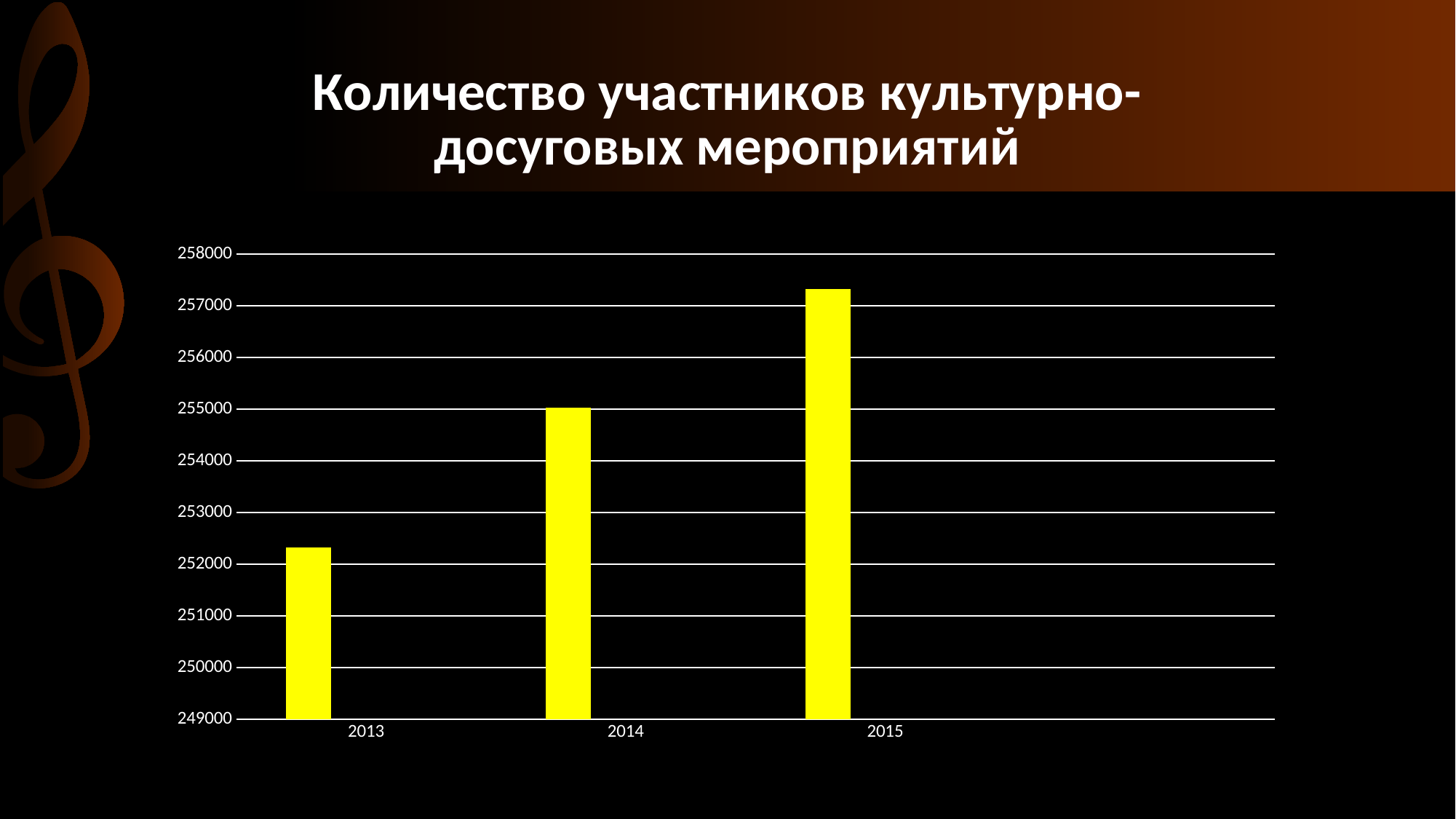
Which year has the highest number of participants? 2015 Which is larger, the value for 2013 or the value for 2015? 2015 What colour are the bars in the chart? yellow Is the value for 2013 greater or less than 253000? less Which year has the lowest number of participants? 2013 Is the value for 2015 greater or less than 257000? greater Do the values rise or fall from 2013 to 2015? rise What kind of chart is shown on the slide? bar chart Is the value for 2014 greater or less than 254000? greater How many years (bars) are shown in the chart? 3 Which is larger, the value for 2014 or the value for 2013? 2014 What is the title of the chart? Количество участников культурно-досуговых мероприятий